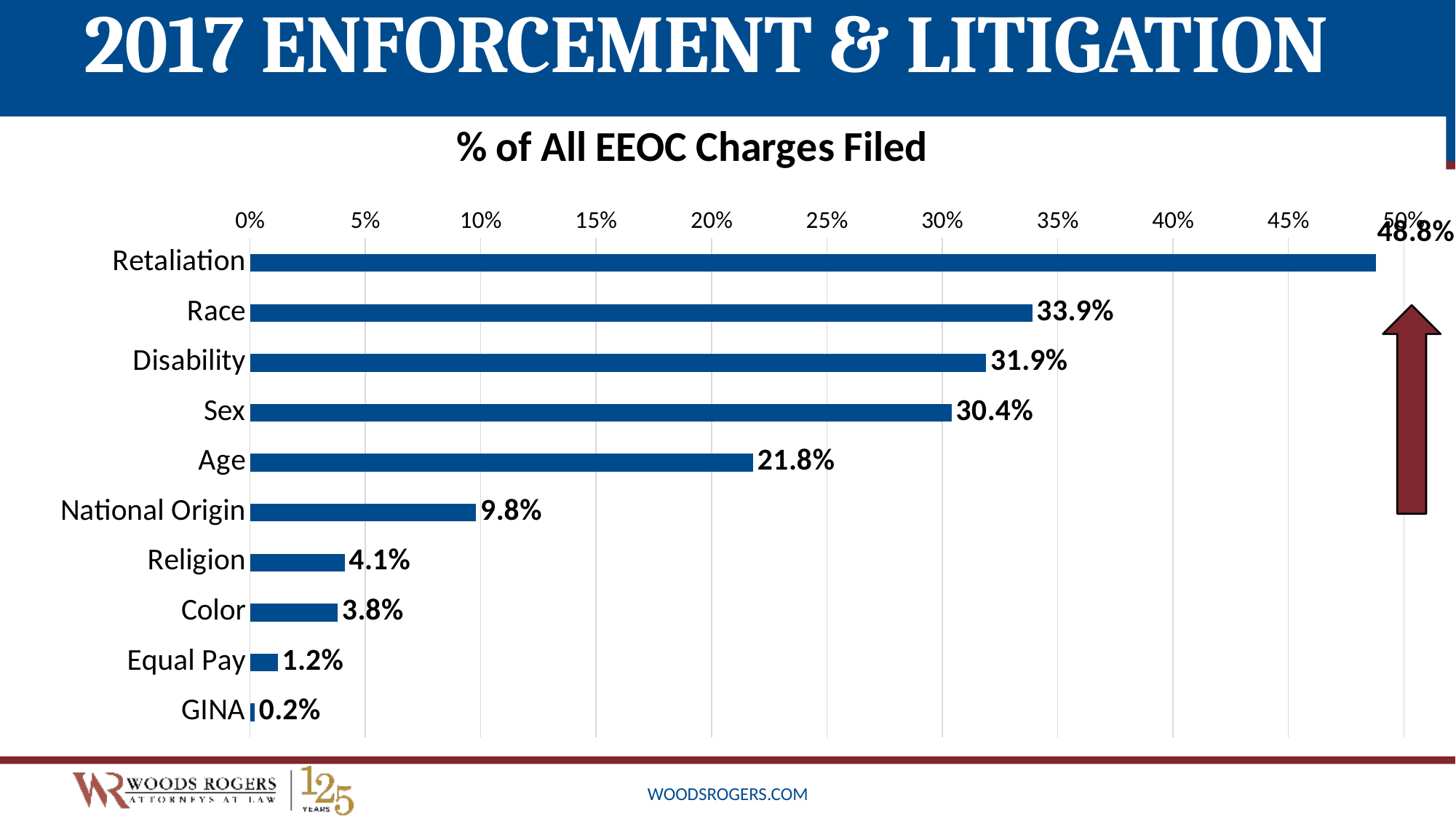
Which category has the highest percentage of EEOC charges filed? Retaliation What is the value shown for Disability? 31.9% Which is larger, the value for Age or the value for National Origin? Age What percentage is shown for National Origin? 9.8% Which category has the lowest percentage of EEOC charges filed? GINA What percentage of all EEOC charges filed were for Retaliation? 48.8% What is the difference between the Race and Sex percentages? 3.5% What is the difference between the Religion and Color percentages? 0.3% How many categories are shown in the chart? 10 What type of chart is shown on the slide? Bar chart What is the value for GINA? 0.2% What is the title of the chart? % of All EEOC Charges Filed